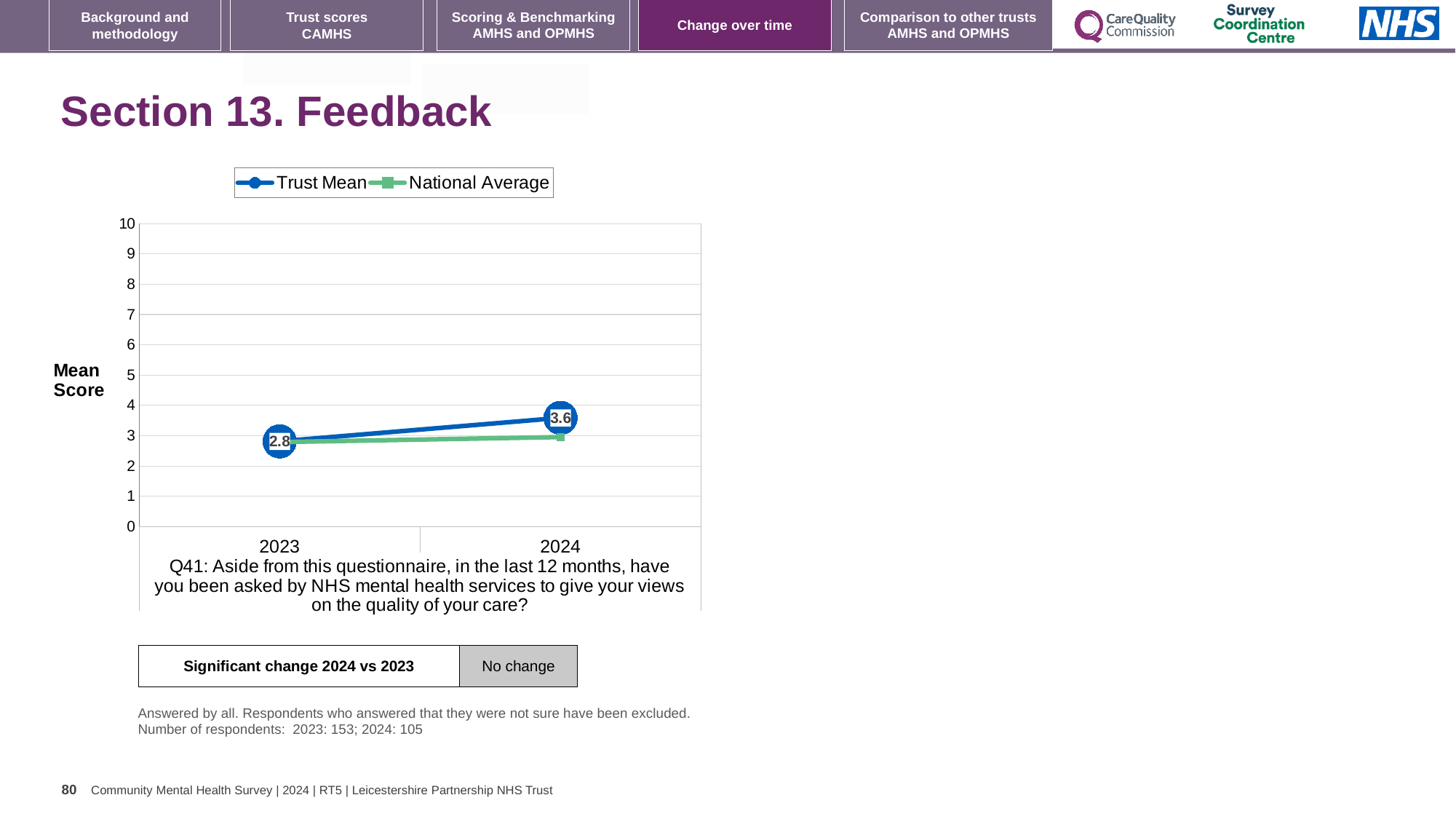
In which year is the Trust Mean higher, 2023 or 2024? 2024 Is the National Average value for 2024 greater or less than 4? less What is the Trust Mean value for 2023? 2.8 How many years are plotted on the x axis? 2 What is the Trust Mean value for 2024? 3.6 By how much did the Trust Mean change from 2023 to 2024? 0.8 What is the label on the y axis of the chart? Mean Score In 2024, which series has the higher value, Trust Mean or National Average? Trust Mean What kind of chart is shown on the slide? line chart How many series does the legend list? 2 Does the Trust Mean rise or fall from 2023 to 2024? rise Is the National Average value for 2023 greater or less than 2? greater